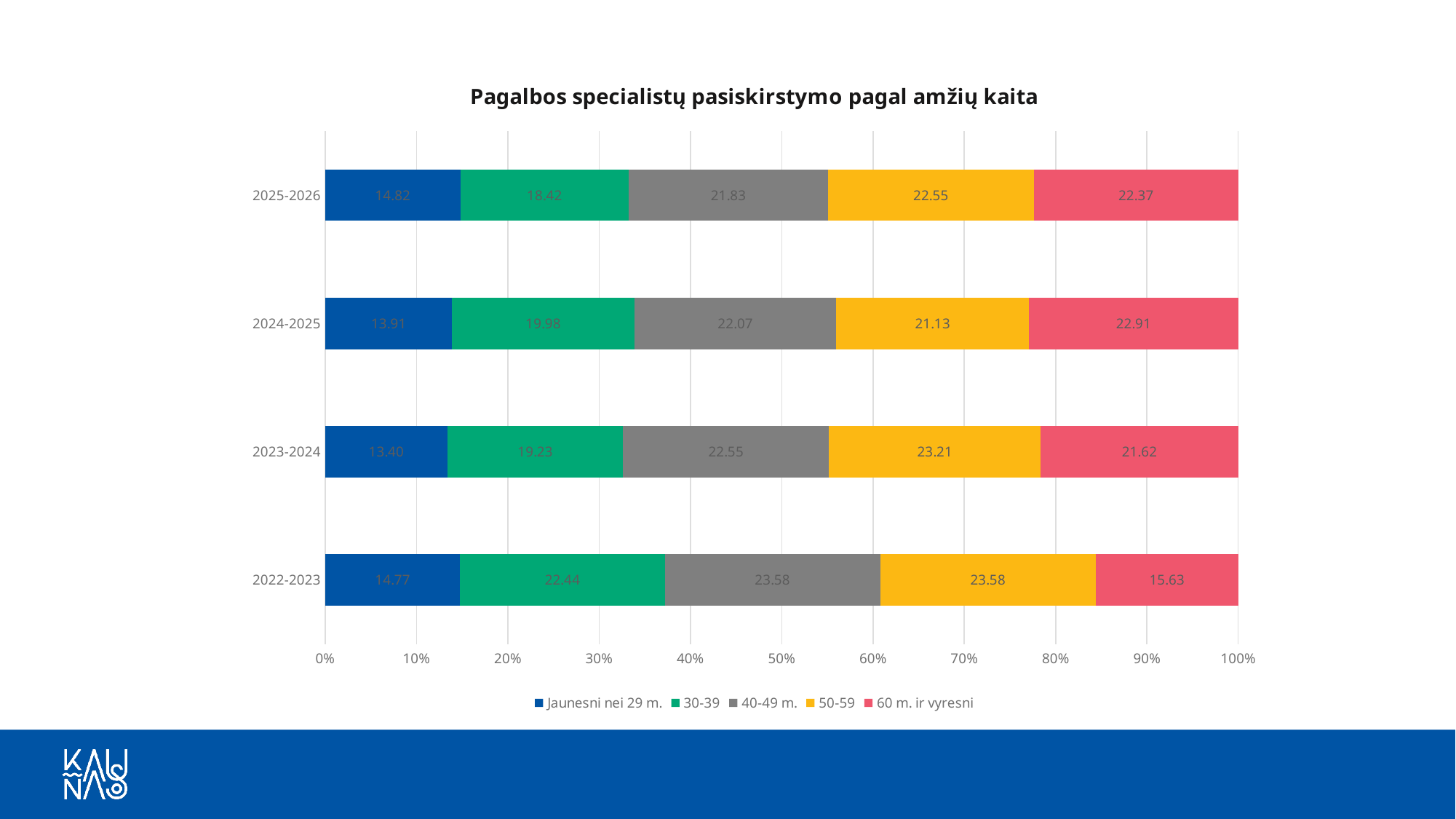
Does the value for 40-49 m. rise or fall from 2022-2023 to 2025-2026? Fall In which period is the value for Jaunesni nei 29 m. the lowest? 2023-2024 What is the value for Jaunesni nei 29 m. in 2025-2026? 14.82 What is the title of the chart? Pagalbos specialistų pasiskirstymo pagal amžių kaita What is the value for 60 m. ir vyresni in 2022-2023? 15.63 What is the value for 40-49 m. in 2024-2025? 22.07 What kind of chart is shown on the slide? Stacked bar chart In which period is the value for 30-39 the highest? 2022-2023 In 2024-2025, which is larger: the value for 50-59 or for 60 m. ir vyresni? 60 m. ir vyresni What is the difference between the 30-39 value in 2022-2023 and in 2025-2026? 4.02 How many periods are shown on the y axis? 4 How many series does the legend list? 5